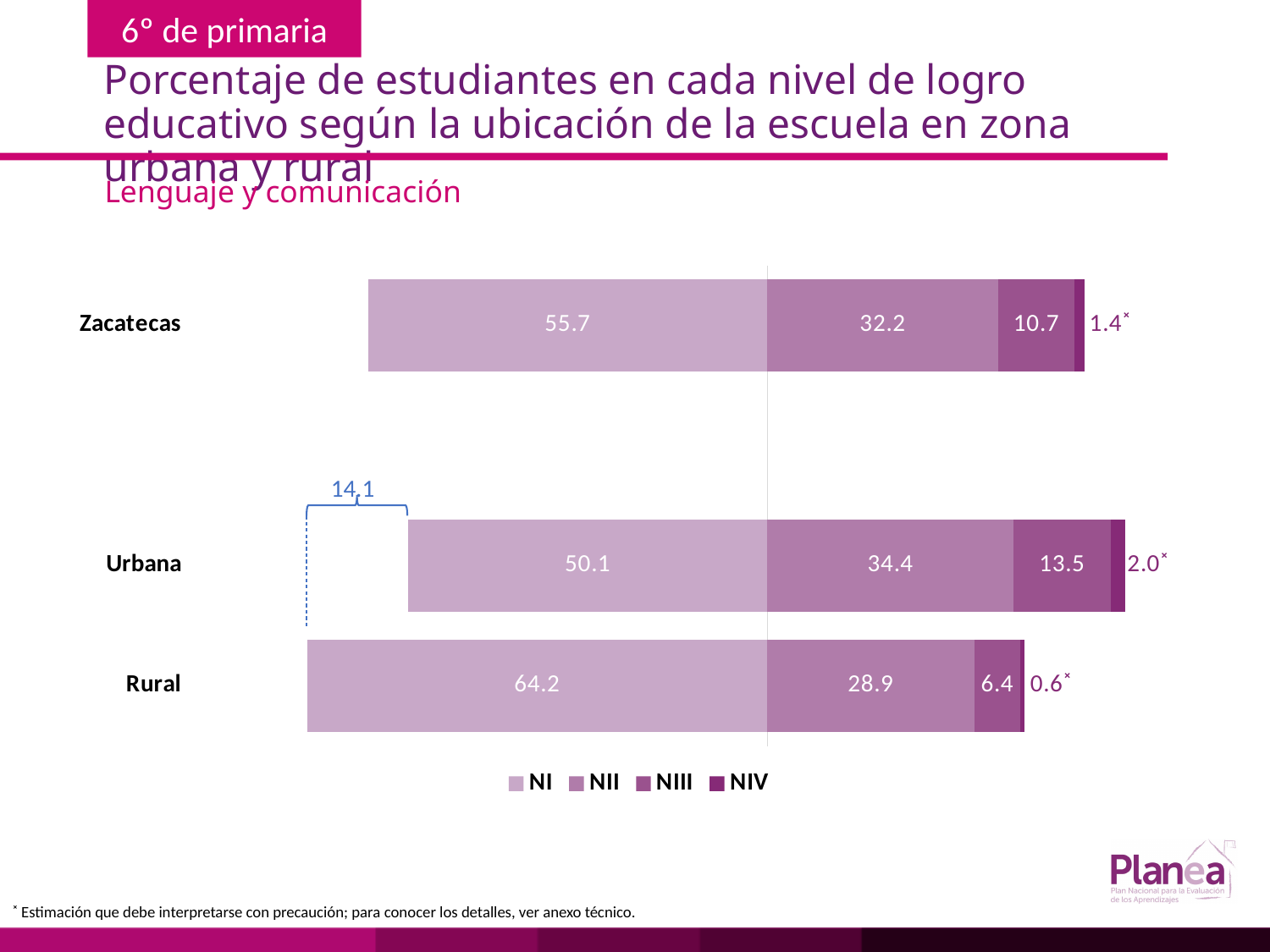
What is the NIII value for Zacatecas? 10.7 What is the difference between the NI values for Rural and Urbana? 14.1 What is the NIV value for Rural? 0.6 Which category has the highest NI value? Rural How many series does the legend list? 4 Which is larger, the NII value for Zacatecas or the NII value for Rural? Zacatecas Which category has the lowest NIII value? Rural What type of chart is shown on the slide? stacked bar chart How many categories are plotted on the chart? 3 What is the NI value for Rural? 64.2 What is the subtitle shown below the chart title? Lenguaje y comunicación What is the NII value for Urbana? 34.4